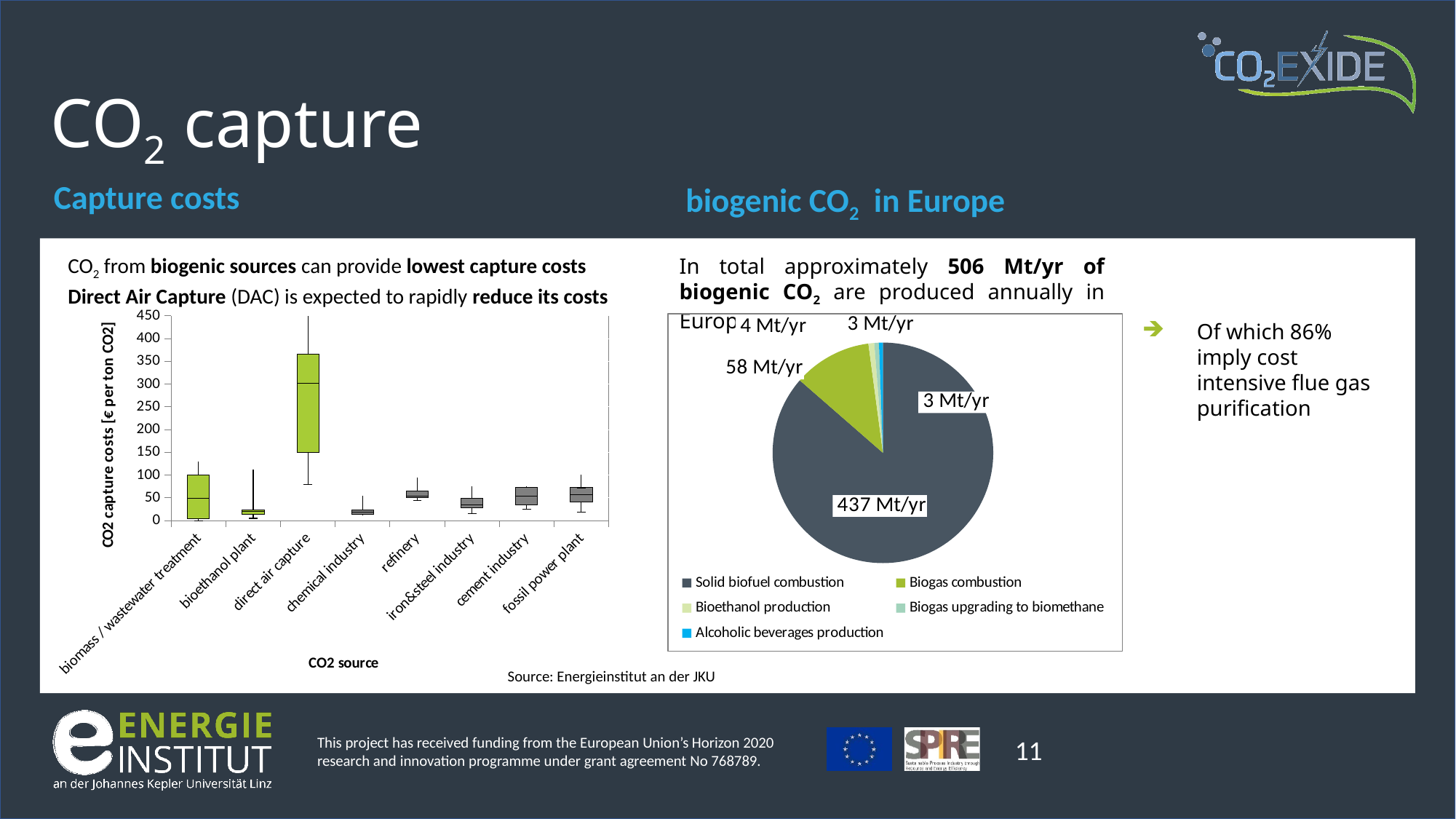
On the 'biogenic CO2 in Europe' pie chart on the right, which source is the largest? Solid biofuel combustion On the 'Capture costs' chart on the left, how many CO2 sources are shown on the x axis? 8 On the 'biogenic CO2 in Europe' pie chart on the right, what is the difference between Solid biofuel combustion and Biogas combustion? 379 Mt/yr On the 'Capture costs' chart on the left, which CO2 source has the highest capture costs? direct air capture On the 'Capture costs' chart on the left, what is the label of the y axis? CO2 capture costs [€ per ton CO2] What kind of chart is the 'biogenic CO2 in Europe' chart on the right? pie chart On the 'biogenic CO2 in Europe' pie chart on the right, what is the value for Biogas combustion? 58 Mt/yr On the 'biogenic CO2 in Europe' pie chart on the right, how many entries does the legend list? 5 What kind of chart is the 'Capture costs' chart on the left? box plot On the 'Capture costs' chart on the left, is the median capture cost for direct air capture greater or less than 200? greater On the 'biogenic CO2 in Europe' pie chart on the right, what is the value for Solid biofuel combustion? 437 Mt/yr On the 'Capture costs' chart on the left, is the median capture cost for fossil power plant greater or less than 100? less